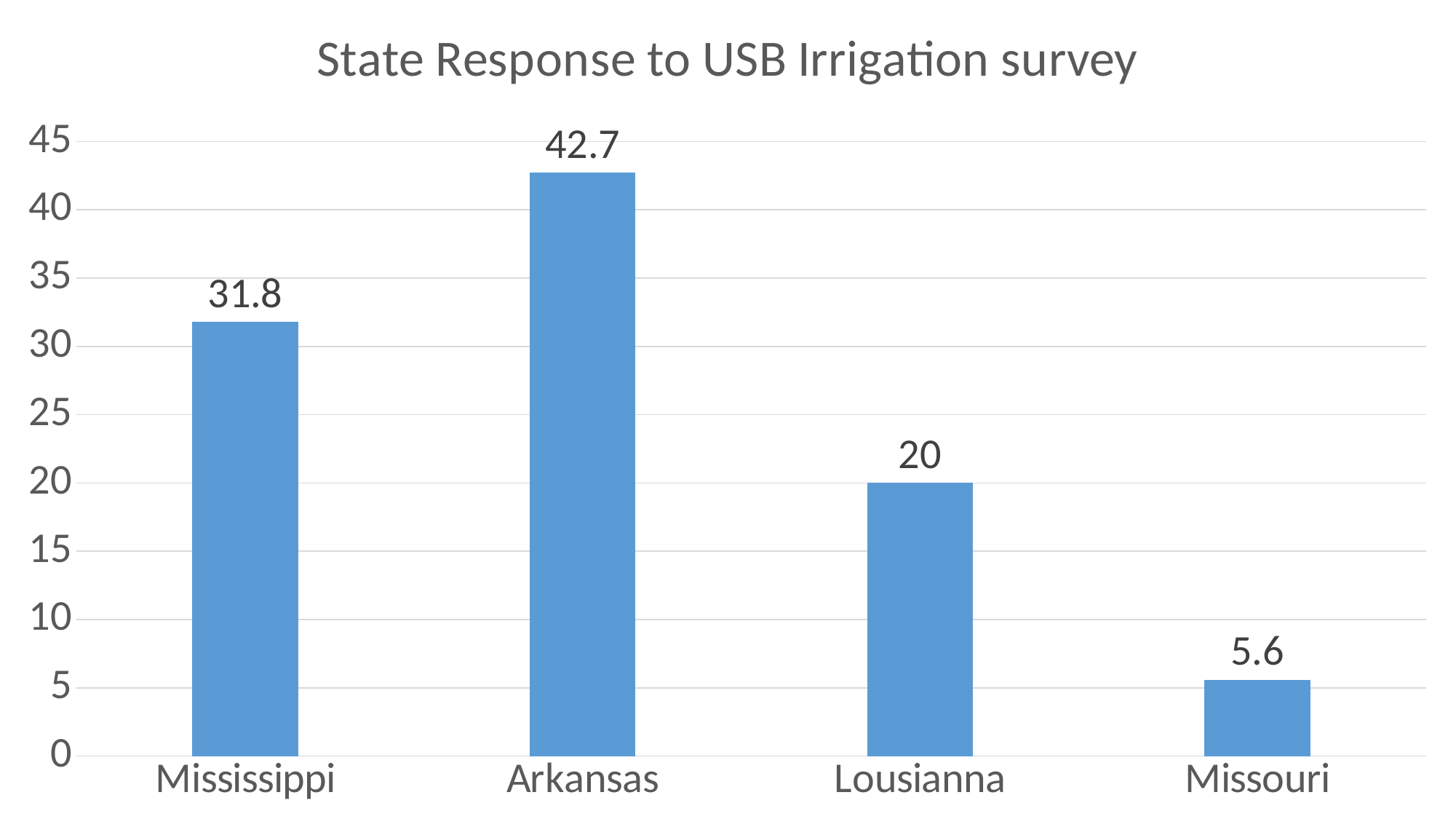
What is the difference between the values for Arkansas and Mississippi? 10.9 Which state has the highest value? Arkansas What is the value for Missouri? 5.6 What is the title of the chart? State Response to USB Irrigation survey What is the difference between the values for Lousianna and Missouri? 14.4 What is the value for Lousianna? 20 How many states are shown in the chart? 4 What is the value for Arkansas? 42.7 What is the value for Mississippi? 31.8 What kind of chart is shown on the slide? Bar chart Which is larger, the value for Mississippi or the value for Lousianna? Mississippi Which state has the lowest value? Missouri